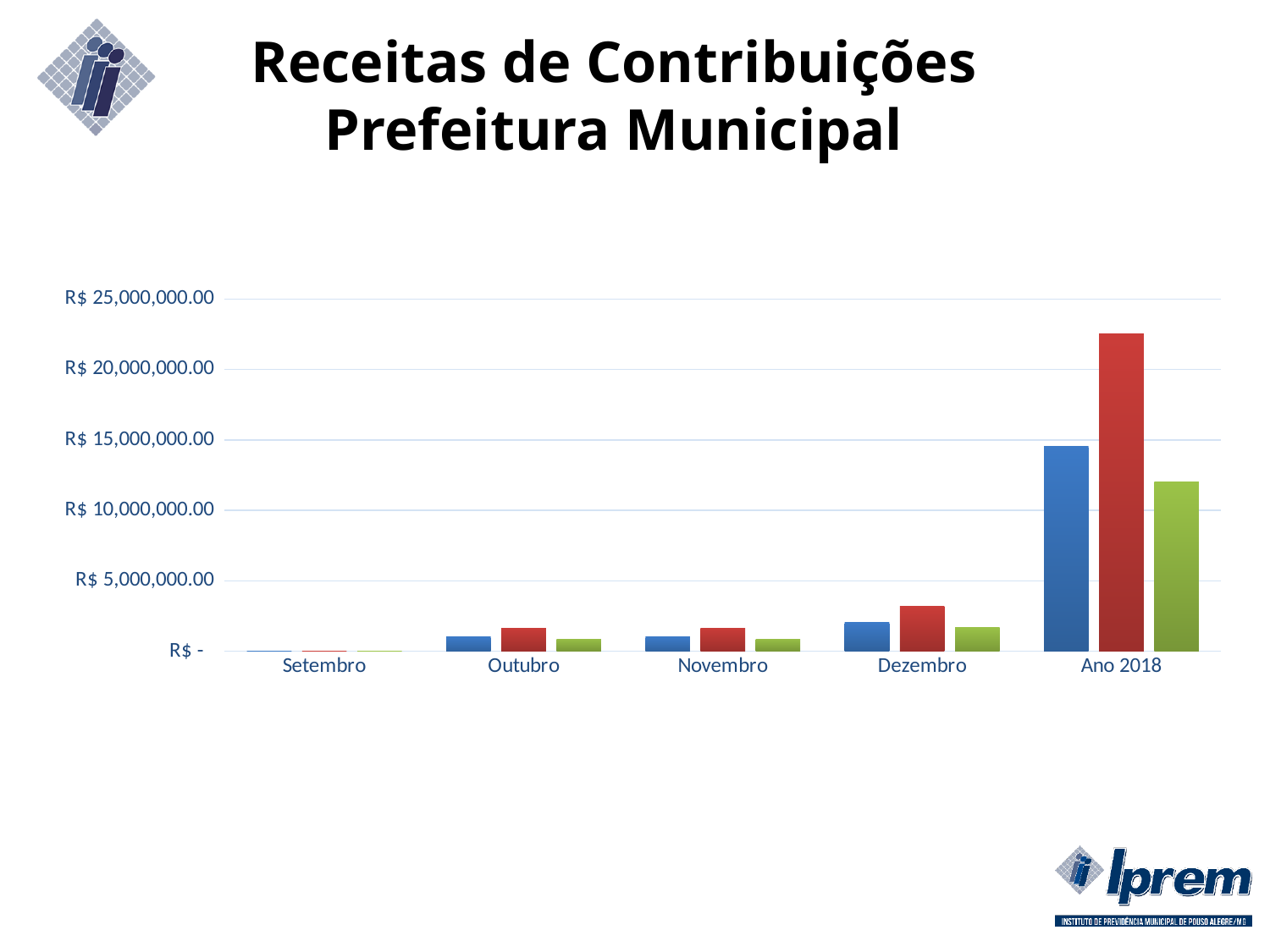
How many categories are shown on the x axis of the chart? 5 Which category has the tallest bars in the chart? Ano 2018 Which is larger in the Ano 2018 category, the blue bar or the green bar? blue What is the title of the chart on the slide? Receitas de Contribuições Prefeitura Municipal Which category has the lowest values in the chart? Setembro Which coloured bar is the tallest in the Ano 2018 category? red How many bars are plotted for each category in the chart? 3 What kind of chart is shown on the slide? bar chart Which is larger, the red bar for Dezembro or the red bar for Outubro? Dezembro Is the value of the red bar for Dezembro greater or less than R$ 5,000,000.00? less Is the value of the red bar for Ano 2018 greater or less than R$ 20,000,000.00? greater Is the value of the green bar for Ano 2018 greater or less than R$ 10,000,000.00? greater